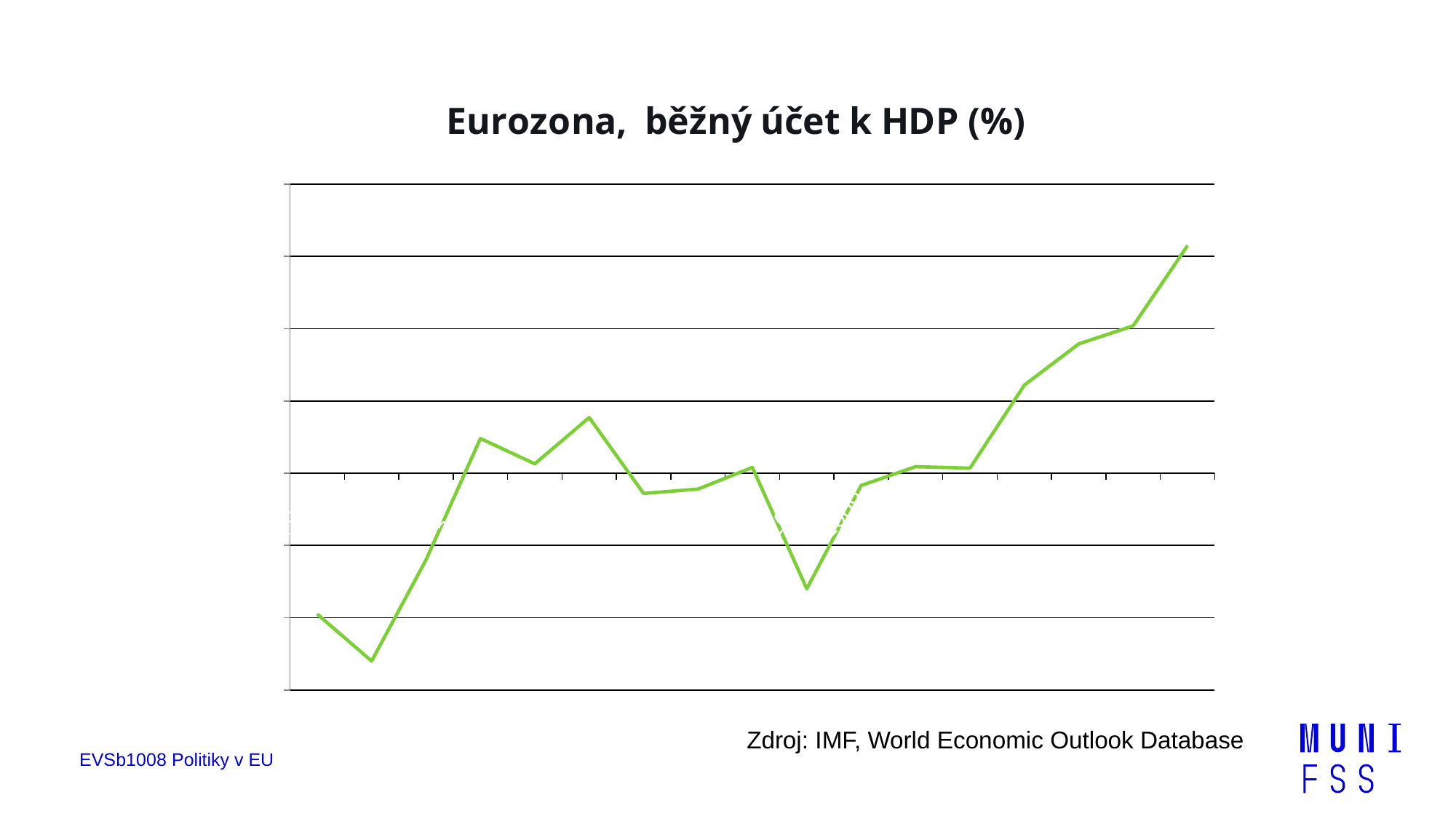
How many data series are plotted in the chart? 1 What is the title of the chart? Eurozona, běžný účet k HDP (%) What kind of chart is shown on the slide? line chart What colour is the plotted line? green Is the last point of the line higher or lower than the first point? higher Is the lowest point of the line located near the left end or the right end of the chart? left end How many data points are plotted on the line? 17 Is the highest point of the line located near the left end or the right end of the chart? right end Overall, does the line rise or fall from the left end of the x axis to the right end? rise